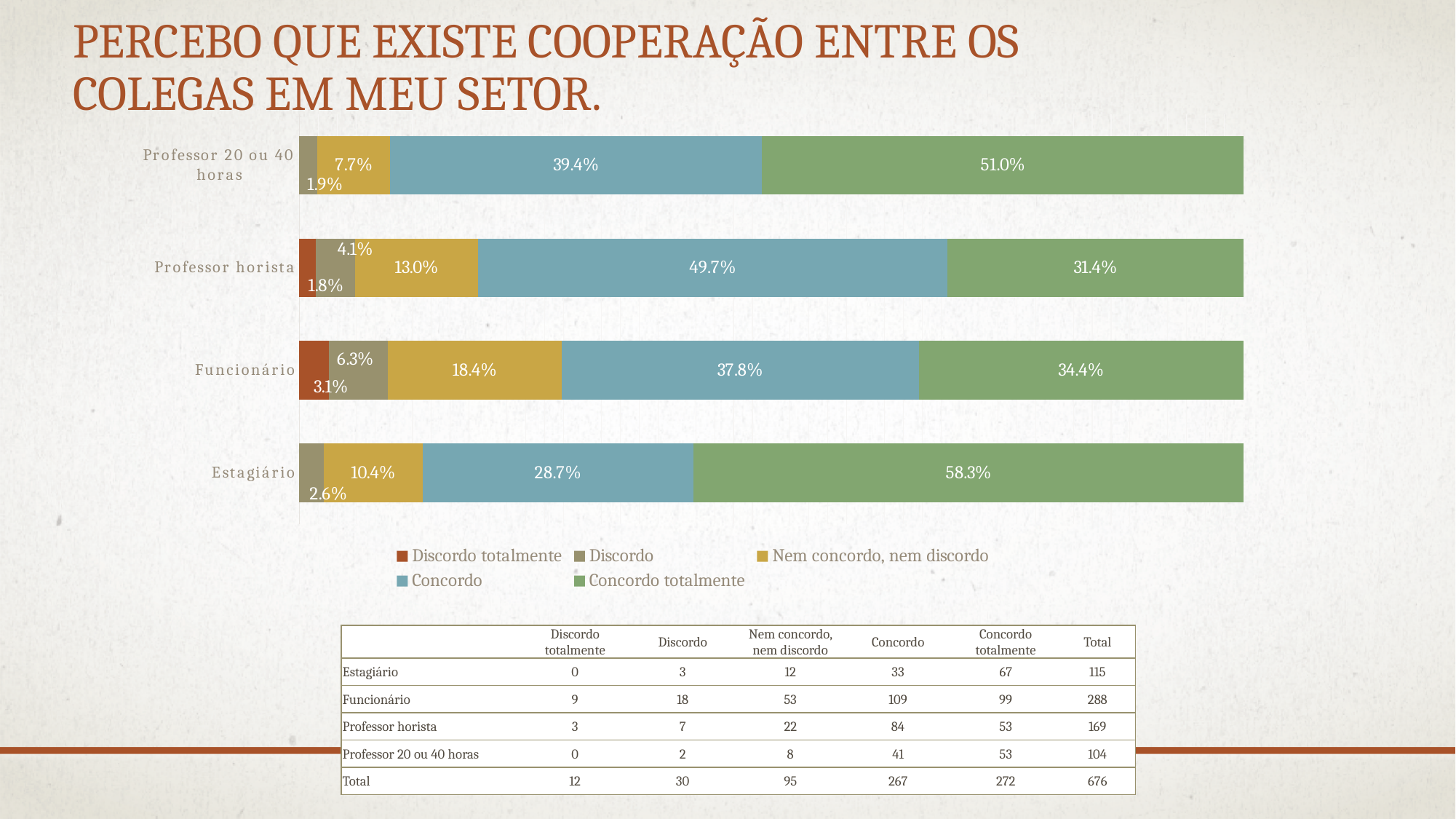
How many series does the legend list? 5 Which category has the lowest "Concordo totalmente" percentage? Professor horista Which category has the highest "Nem concordo, nem discordo" percentage? Funcionário What is the "Concordo" percentage for Professor horista? 49.7% What colour represents "Concordo totalmente" in the chart? Green What is the "Nem concordo, nem discordo" percentage for Funcionário? 18.4% What kind of chart is shown on the slide? Stacked bar chart Which has a larger "Concordo" percentage: Funcionário or Professor 20 ou 40 horas? Professor 20 ou 40 horas Which category has the highest "Concordo totalmente" percentage? Estagiário How many categories (respondent groups) are shown in the chart? 4 What is the difference in percentage points between the "Concordo totalmente" values for Estagiário and Professor 20 ou 40 horas? 7.3 percentage points What percentage of Estagiário respondents answered "Concordo totalmente"? 58.3%